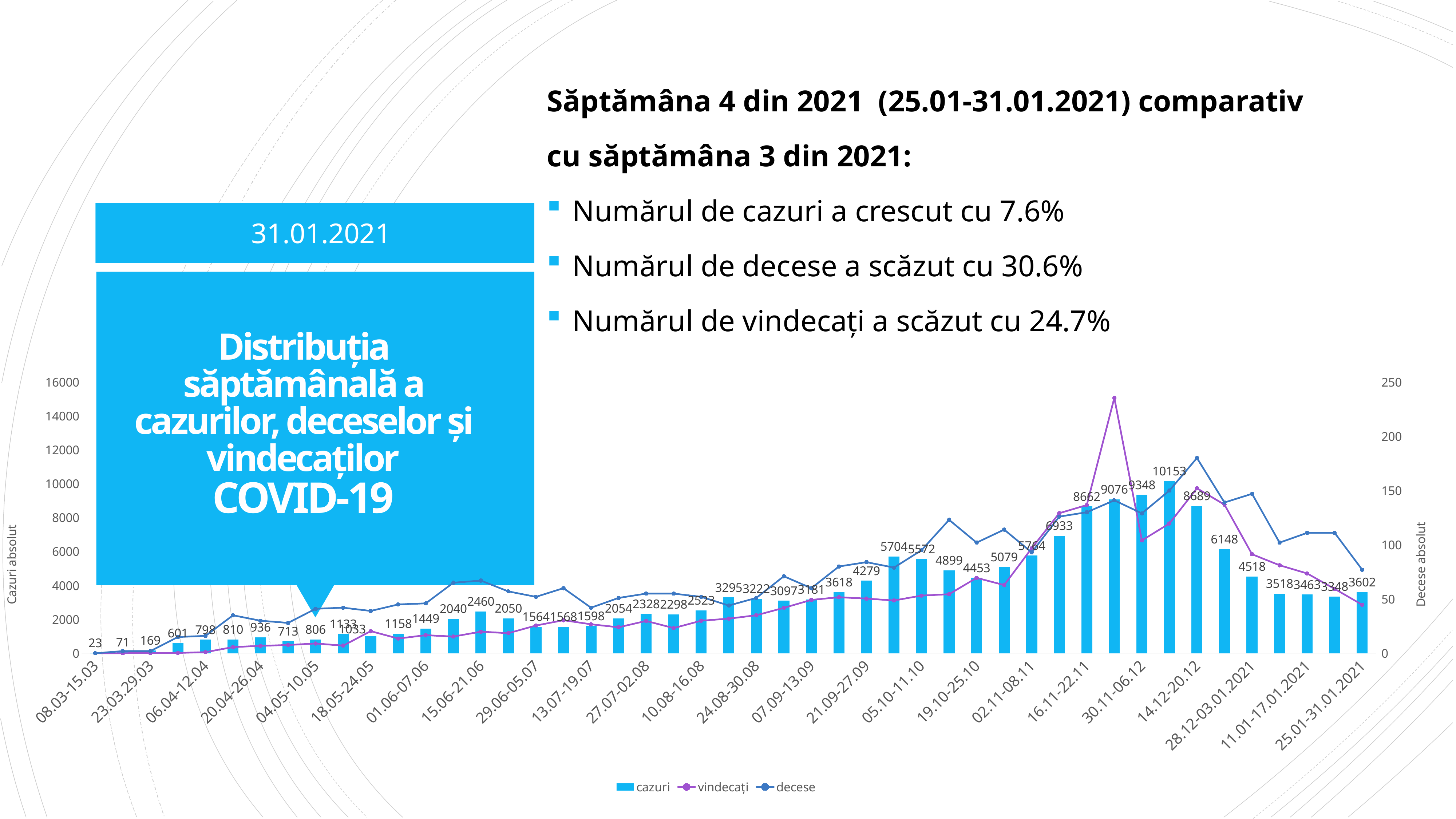
Is the decese value for the week 30.11-06.12 greater or less than 100? greater How many series does the legend list? 3 Is the decese value for the week 25.01-31.01.2021 greater or less than 50? greater What is the number of cazuri for the week 16.11-22.11? 8662 What is the number of cazuri for the week 14.12-20.12? 8689 Do the cazuri values rise or fall from the week 14.12-20.12 to the week 11.01-17.01.2021? fall What is the difference in cazuri between the weeks 25.01-31.01.2021 and 11.01-17.01.2021? 139 Which week has the lowest number of cazuri? 08.03-15.03 What is the number of cazuri for the week 25.01-31.01.2021? 3602 What is the highest weekly value of cazuri shown on the chart? 10153 What kind of chart is shown on the slide? Combined bar and line chart Which week has more cazuri, 30.11-06.12 or 14.12-20.12? 30.11-06.12